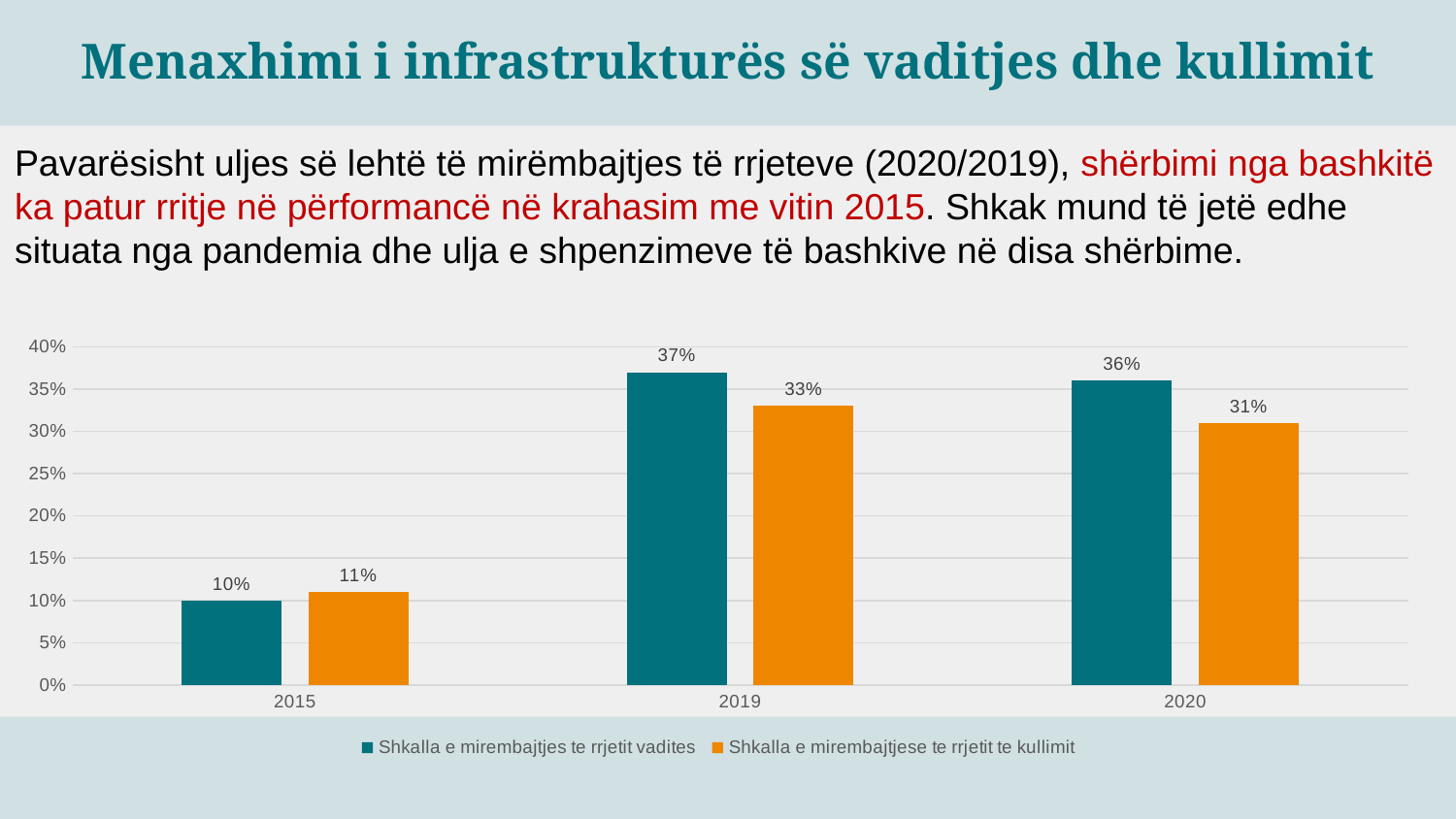
How many years are shown on the x axis? 3 What kind of chart is shown on the slide? Bar chart What is the value of 'Shkalla e mirembajtjese te rrjetit te kullimit' for 2015? 11% In which year is 'Shkalla e mirembajtjese te rrjetit te kullimit' lowest? 2015 What is the value of 'Shkalla e mirembajtjese te rrjetit te kullimit' for 2020? 31% In which year is 'Shkalla e mirembajtjes te rrjetit vadites' highest? 2019 What is the difference between the two series in 2020? 5% What is the value of 'Shkalla e mirembajtjes te rrjetit vadites' for 2019? 37% Does 'Shkalla e mirembajtjes te rrjetit vadites' rise or fall from 2019 to 2020? Fall What is the difference between 'Shkalla e mirembajtjes te rrjetit vadites' in 2019 and in 2015? 27% How many series does the legend list? 2 Which is larger in 2015: 'Shkalla e mirembajtjes te rrjetit vadites' or 'Shkalla e mirembajtjese te rrjetit te kullimit'? Shkalla e mirembajtjese te rrjetit te kullimit